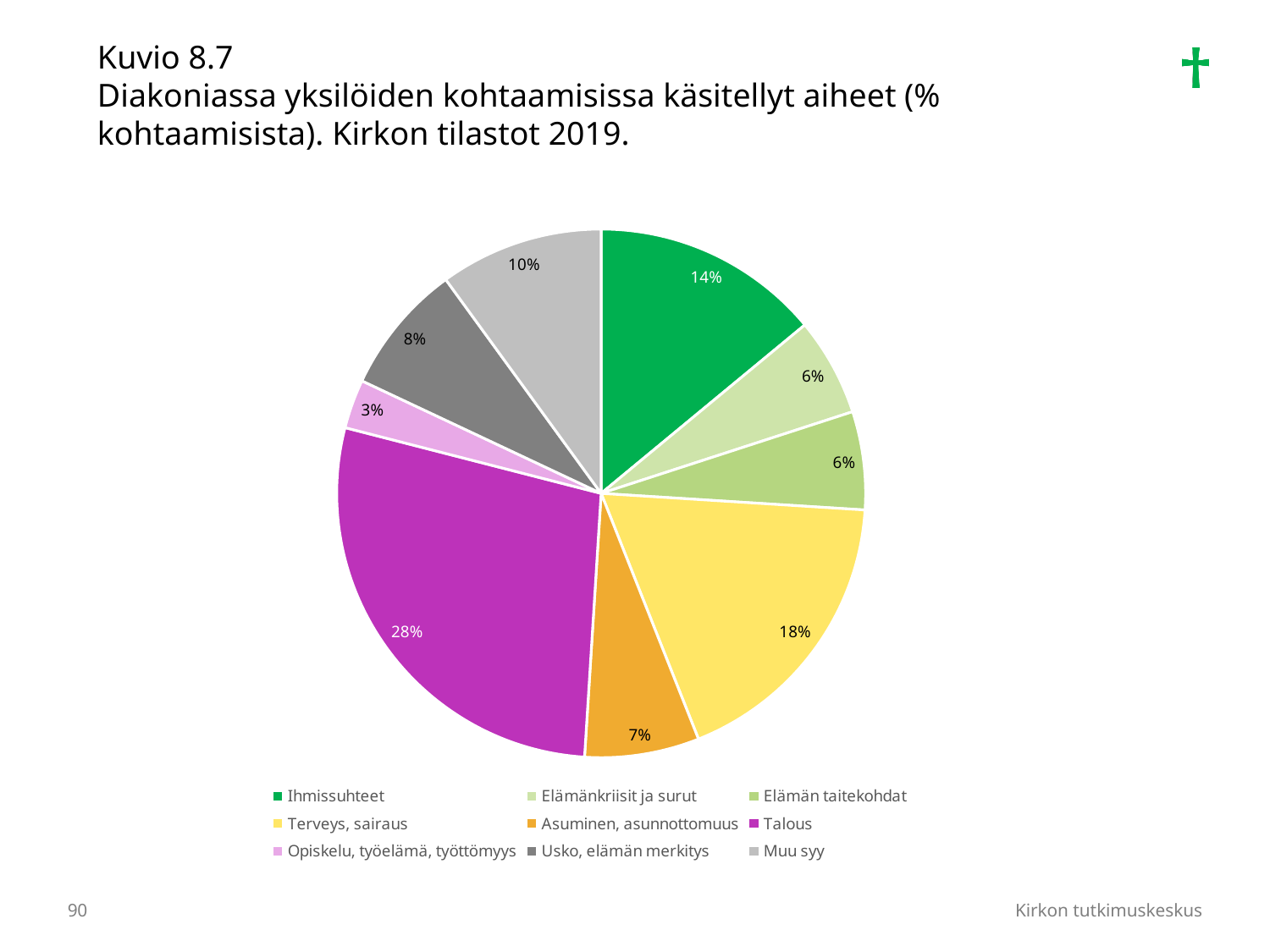
How many categories does the pie chart contain? 9 Which category has the smallest share of the pie? Opiskelu, työelämä, työttömyys What percentage is shown for Opiskelu, työelämä, työttömyys? 3% What is the value shown for Terveys, sairaus? 18% What is the difference in percentage points between Talous and Terveys, sairaus? 10 What type of chart is shown on the slide? Pie chart What percentage is shown for Ihmissuhteet? 14% Which category has the largest share of the pie? Talous What is the value for Usko, elämän merkitys? 8% What colour is the Talous slice? Purple Which is larger, the share for Muu syy or the share for Asuminen, asunnottomuus? Muu syy What percentage of encounters does the Talous slice represent? 28%